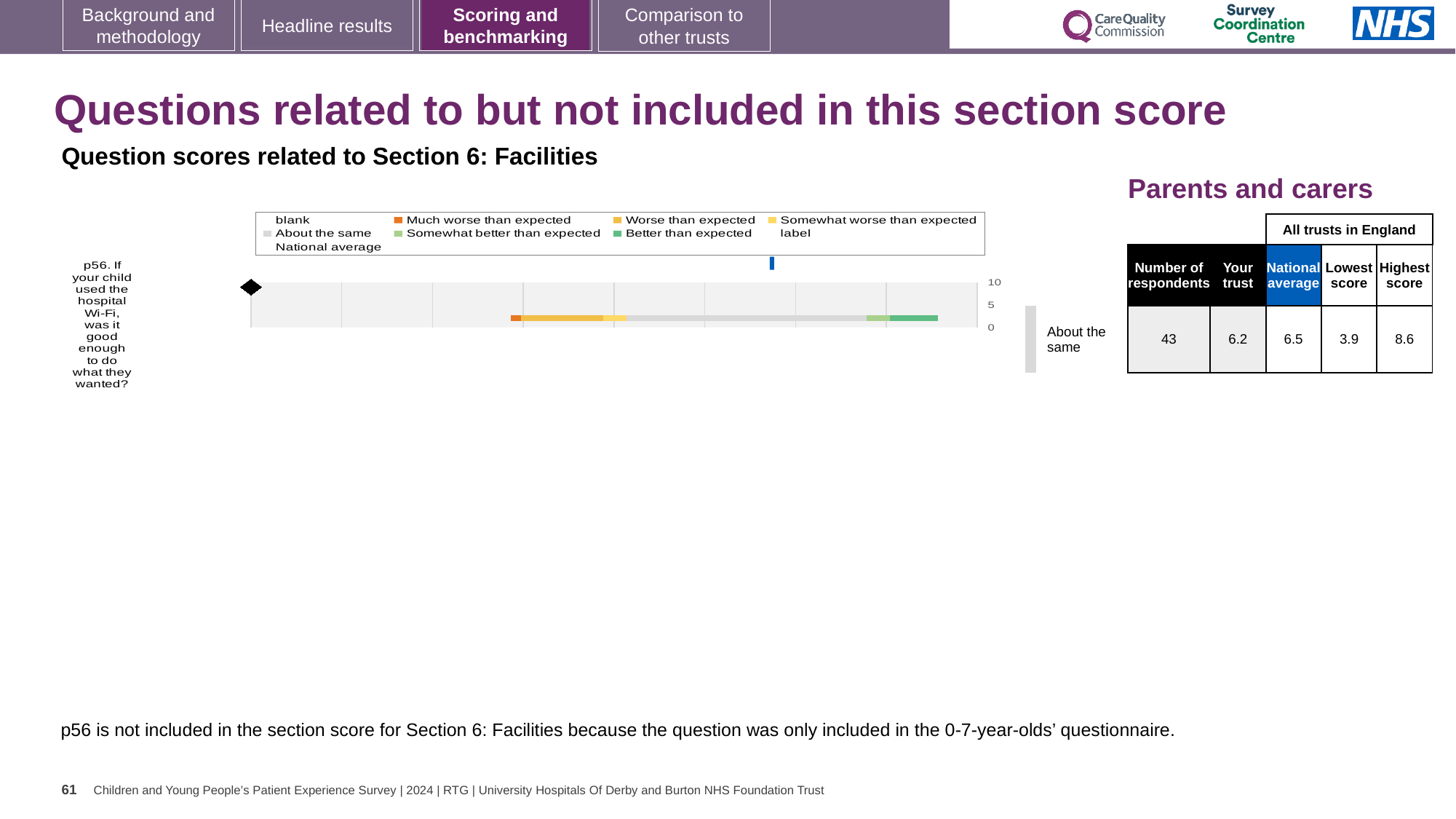
In the chart legend, what colour represents 'Much worse than expected'? Orange According to the table beside the chart, what is the national average score for p56? 6.5 How many questions (categories) are plotted in the chart? 1 What rating category is shown next to the chart for question p56? About the same According to the table beside the chart, what is the lowest score among all trusts in England for p56? 3.9 According to the table beside the chart, what is the 'Your trust' score for p56? 6.2 According to the table beside the chart, what is the highest score among all trusts in England for p56? 8.6 Which question is plotted in the chart? p56. If your child used the hospital Wi-Fi, was it good enough to do what they wanted? How many respondents answered question p56, according to the table beside the chart? 43 Which is larger for p56: the 'Your trust' score or the national average? National average What kind of chart is shown on the slide? bar chart What is the difference between the highest score and the lowest score for p56 in the table beside the chart? 4.7